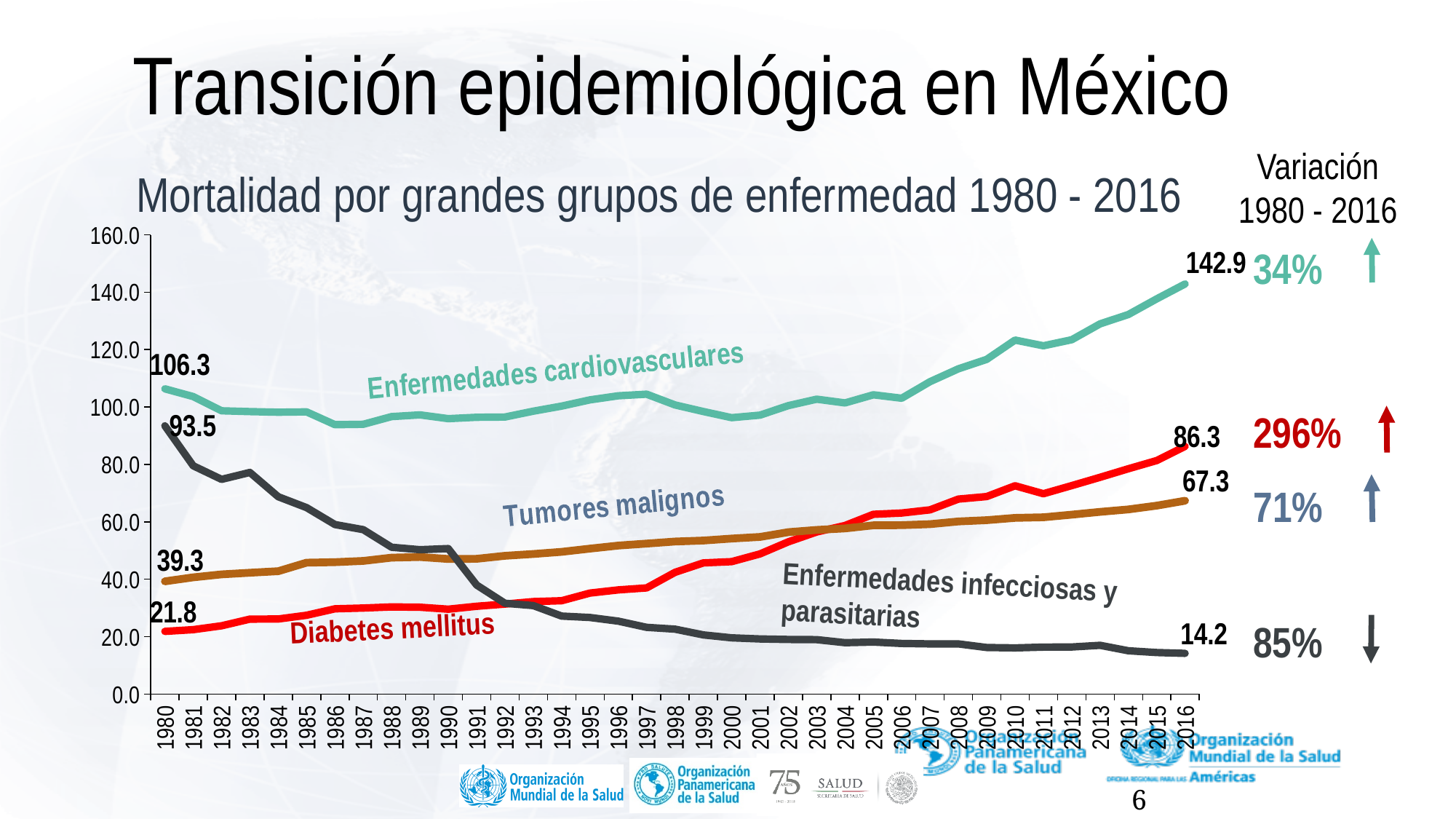
What is the value for Tumores malignos in 1980? 39.3 What is the difference between the 2016 and 1980 values for Enfermedades cardiovasculares? 36.6 Is the value for Enfermedades cardiovasculares in 2000 greater or less than 100.0? less Which series has the lowest value in 1980? Diabetes mellitus Which is larger in 2016: Tumores malignos or Diabetes mellitus? Diabetes mellitus What percentage variation 1980 - 2016 is shown for Diabetes mellitus? 296% Does the Enfermedades infecciosas y parasitarias line rise or fall from 1980 to 2016? fall What is the value for Enfermedades cardiovasculares in 2016? 142.9 What is the value for Diabetes mellitus in 2016? 86.3 What is the value for Enfermedades infecciosas y parasitarias in 1980? 93.5 Which series has the highest value in 2016? Enfermedades cardiovasculares What type of chart is shown on the slide? line chart